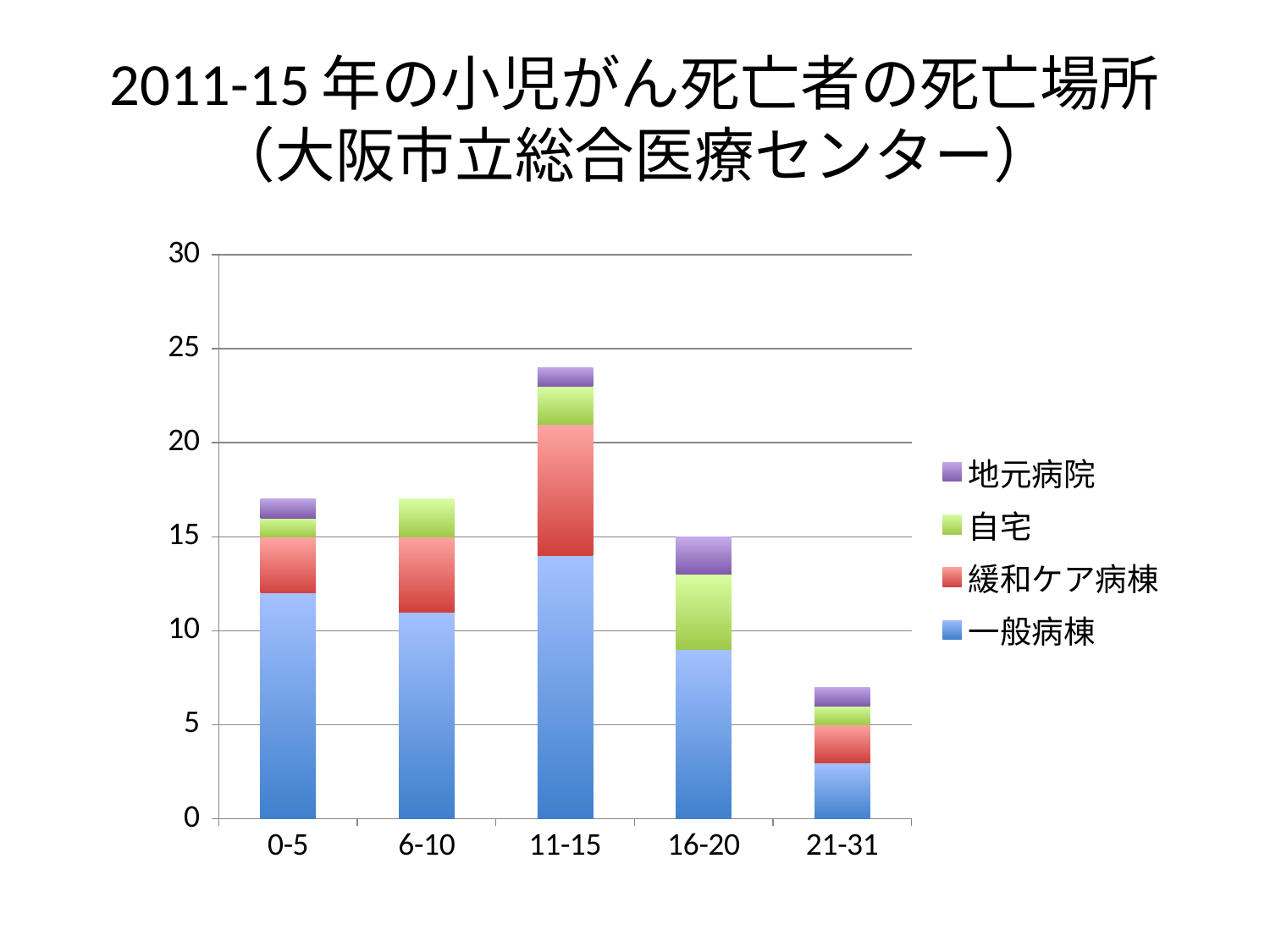
How many series does the legend list? 4 Is the total for the 21-31 age group greater or less than 10? less How many age-group categories are shown on the x axis? 5 Which legend entry is listed first (at the top) in the legend? 地元病院 Which legend entry is shown in blue? 一般病棟 Which age group has the largest 一般病棟 segment? 11-15 Which age group has the shortest stacked bar overall? 21-31 Is the total for the 0-5 age group greater or less than 15? greater Is the total for the 11-15 age group greater or less than 20? greater What kind of chart is shown on the slide? Stacked bar chart Which has the larger total, the 11-15 age group or the 16-20 age group? 11-15 Which age group has the tallest stacked bar overall? 11-15